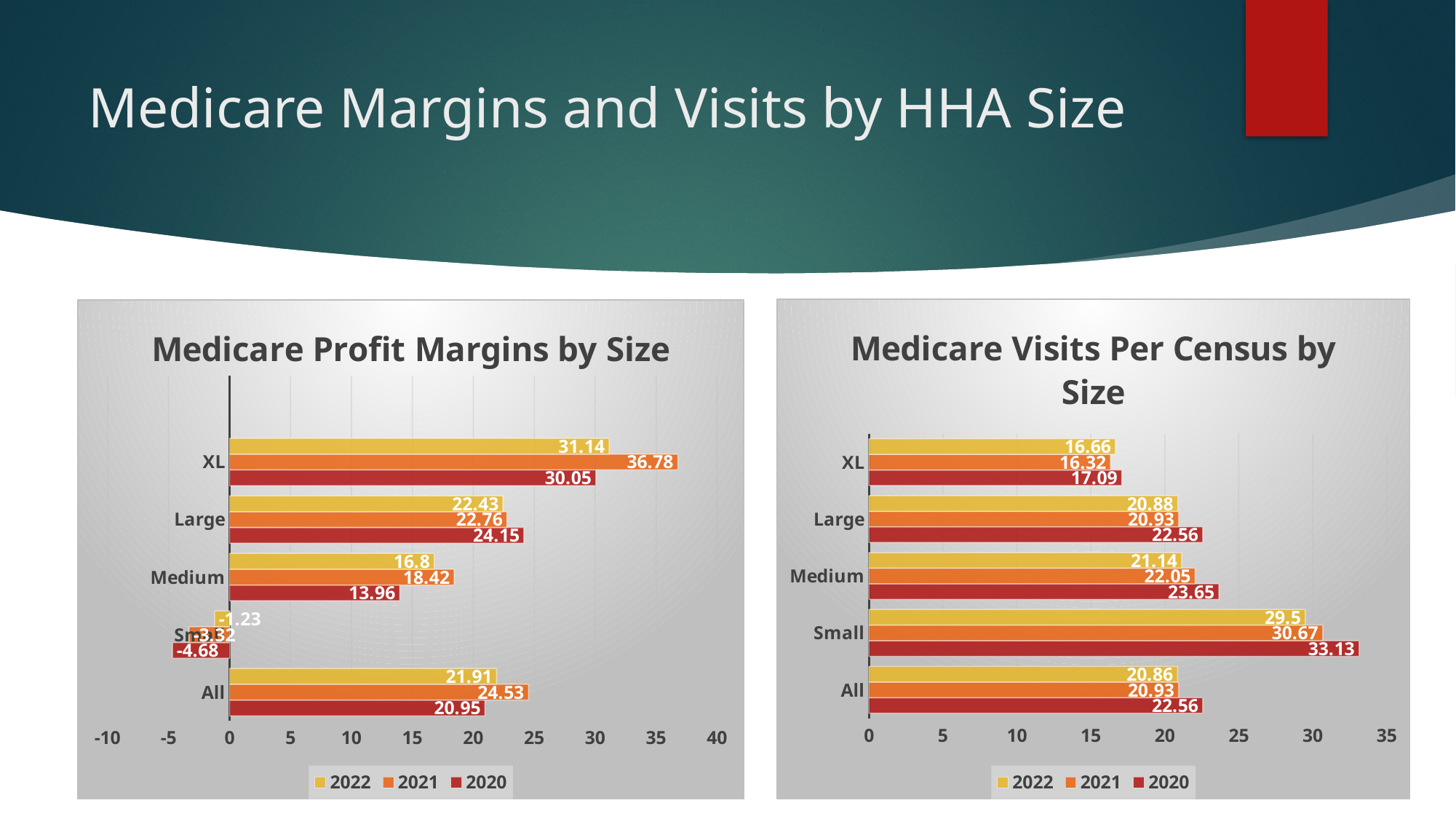
In the Medicare Visits Per Census by Size chart, which size category has the lowest 2022 value? XL What type of chart is the Medicare Visits Per Census by Size chart? Bar chart In the Medicare Profit Margins by Size chart, which size category has the lowest 2020 value? Small In the Medicare Visits Per Census by Size chart, is the 2021 value for Small larger or the 2021 value for Large? Small In the Medicare Profit Margins by Size chart, what is the 2020 value for Medium? 13.96 In the Medicare Visits Per Census by Size chart, what is the 2022 value for Medium? 21.14 In the Medicare Profit Margins by Size chart, how many series does the legend list? 3 In the Medicare Visits Per Census by Size chart, how many size categories are shown? 5 In the Medicare Profit Margins by Size chart, what is the difference between the 2021 and 2020 values for XL? 6.73 In the Medicare Profit Margins by Size chart, what is the 2021 value for XL? 36.78 In the Medicare Profit Margins by Size chart, which size category has the highest 2022 value? XL In the Medicare Visits Per Census by Size chart, what is the 2020 value for Small? 33.13